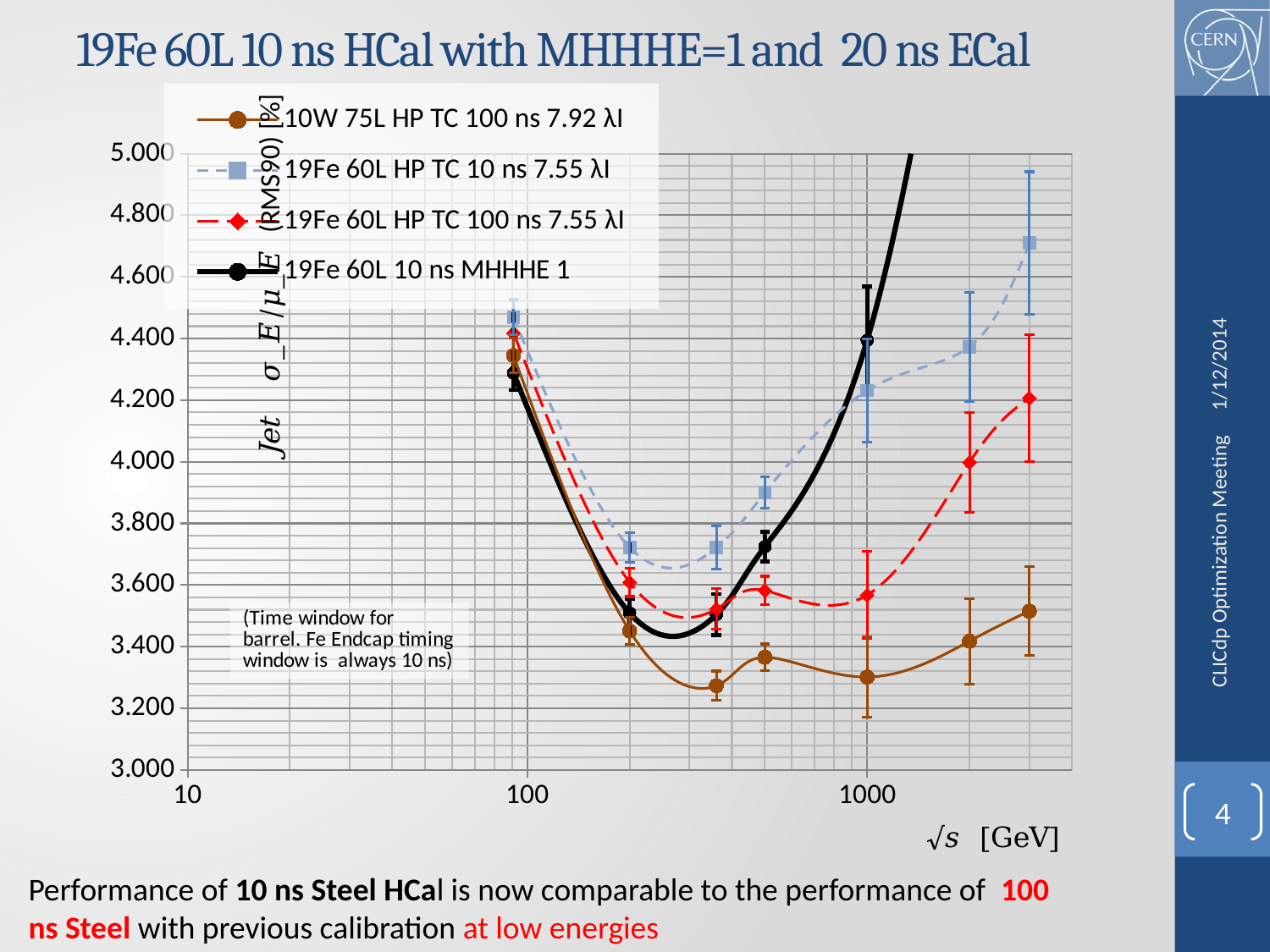
Does the '19Fe 60L HP TC 10 ns 7.55 λI' series rise or fall between 1000 GeV and 3000 GeV? rise What is the title of the chart? 19Fe 60L 10 ns HCal with MHHHE=1 and 20 ns ECal Is the value of the '19Fe 60L HP TC 10 ns 7.55 λI' series at 3000 GeV greater or less than 4.600? greater At 3000 GeV, which series has the higher value: '19Fe 60L HP TC 10 ns 7.55 λI' or '10W 75L HP TC 100 ns 7.92 λI'? 19Fe 60L HP TC 10 ns 7.55 λI How many series does the legend list? 4 Is the value of the '19Fe 60L HP TC 10 ns 7.55 λI' series at 500 GeV greater or less than 3.800? greater What quantity is plotted on the x axis? √s [GeV] Is the value of the '19Fe 60L 10 ns MHHHE 1' series at 1000 GeV greater or less than 4.200? greater Which series has the lowest value at 1000 GeV? 10W 75L HP TC 100 ns 7.92 λI What kind of chart is shown on the slide? line chart